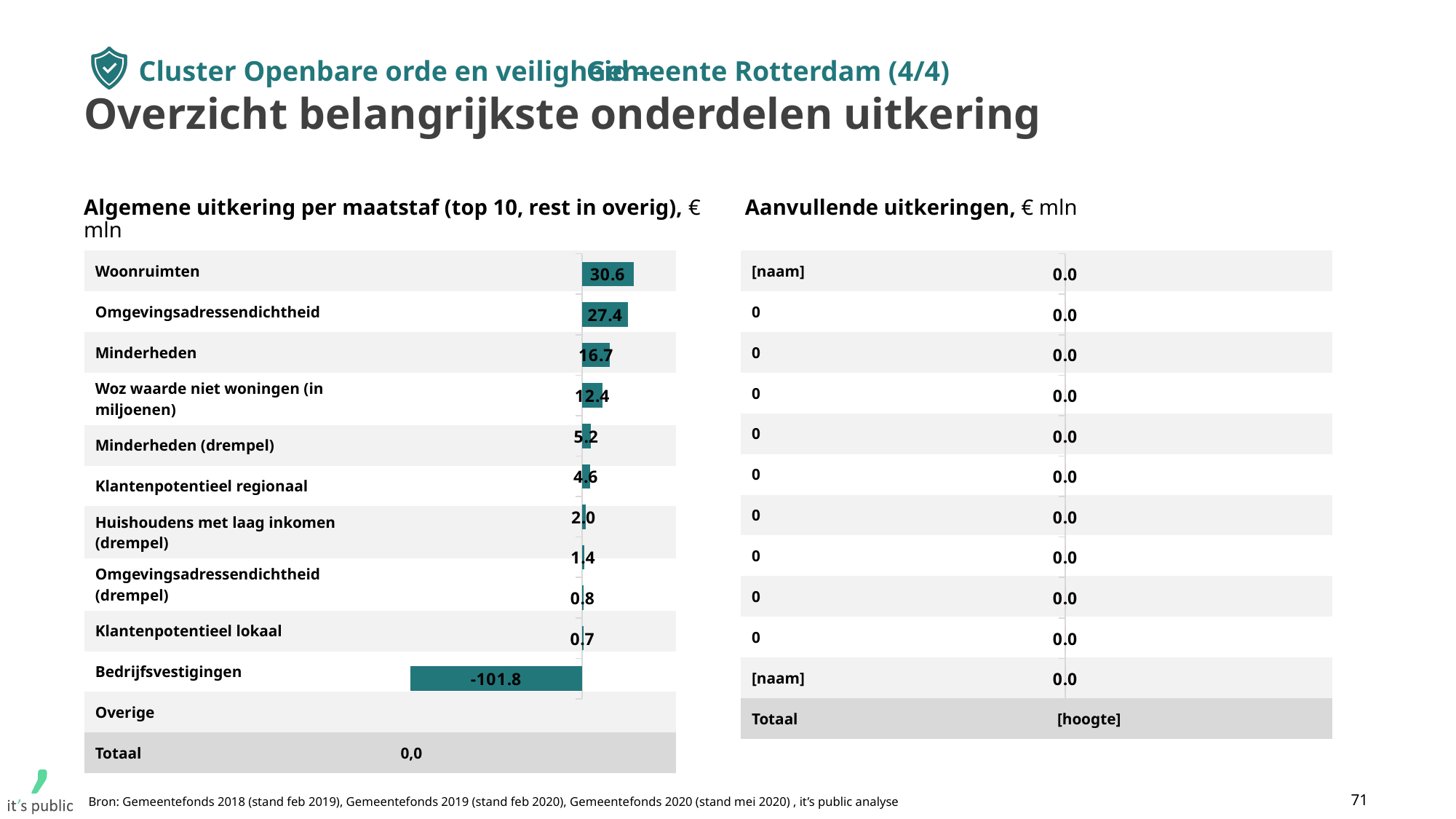
In the chart 'Algemene uitkering per maatstaf', what is the value for Omgevingsadressendichtheid? 27.4 In the chart 'Algemene uitkering per maatstaf', what is the value for Klantenpotentieel regionaal? 4.6 What is the Totaal shown at the bottom of the chart 'Algemene uitkering per maatstaf'? 0,0 In the chart 'Algemene uitkering per maatstaf', what is the value shown on the large negative bar? -101.8 In the chart 'Algemene uitkering per maatstaf', which category has the highest value? Woonruimten What unit is given in the title of the chart 'Aanvullende uitkeringen'? € mln What kind of chart is 'Algemene uitkering per maatstaf'? bar chart In the chart 'Algemene uitkering per maatstaf', which is larger: Minderheden or Minderheden (drempel)? Minderheden In the chart 'Algemene uitkering per maatstaf', what is the difference between Woonruimten and Omgevingsadressendichtheid? 3.2 In the chart 'Algemene uitkering per maatstaf', what is the value for Woz waarde niet woningen (in miljoenen)? 12.4 In the chart 'Algemene uitkering per maatstaf', what is the value for Woonruimten? 30.6 In the chart 'Algemene uitkering per maatstaf', what is the value for Minderheden? 16.7